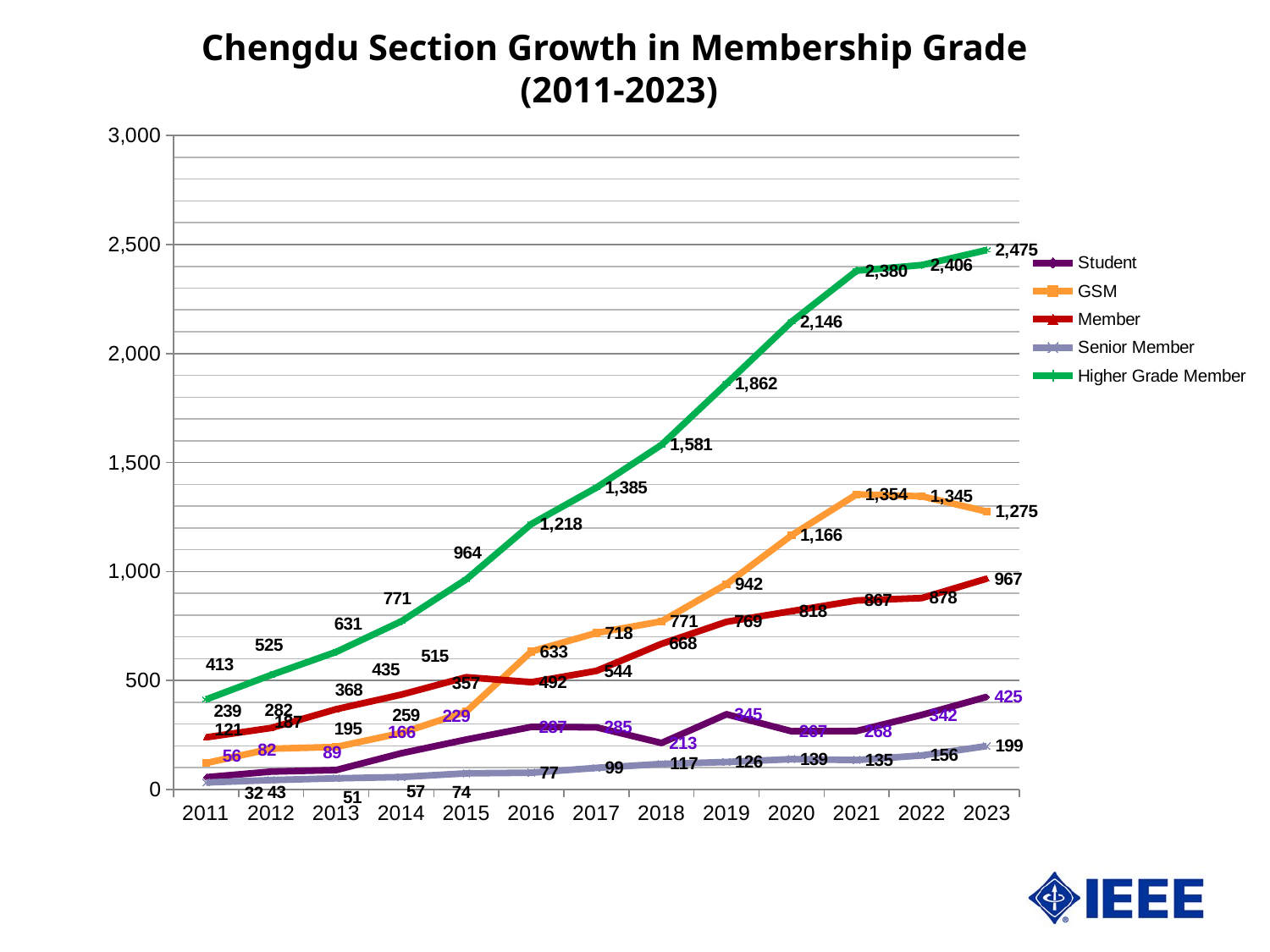
Which series has the highest value in 2023? Higher Grade Member What is the value for Senior Member in 2023? 199 Does the Higher Grade Member line rise or fall from 2011 to 2023? rise What is the value for Member in 2019? 769 What is the value for Higher Grade Member in 2023? 2,475 How many series does the legend list? 5 Which series has the lowest value in 2023? Senior Member What kind of chart is shown on the slide? line chart By how much did Higher Grade Member grow from 2011 to 2023? 2,062 In 2020, which is larger, GSM or Member? GSM What is the value for GSM in 2021? 1,354 How many years are plotted along the x axis? 13